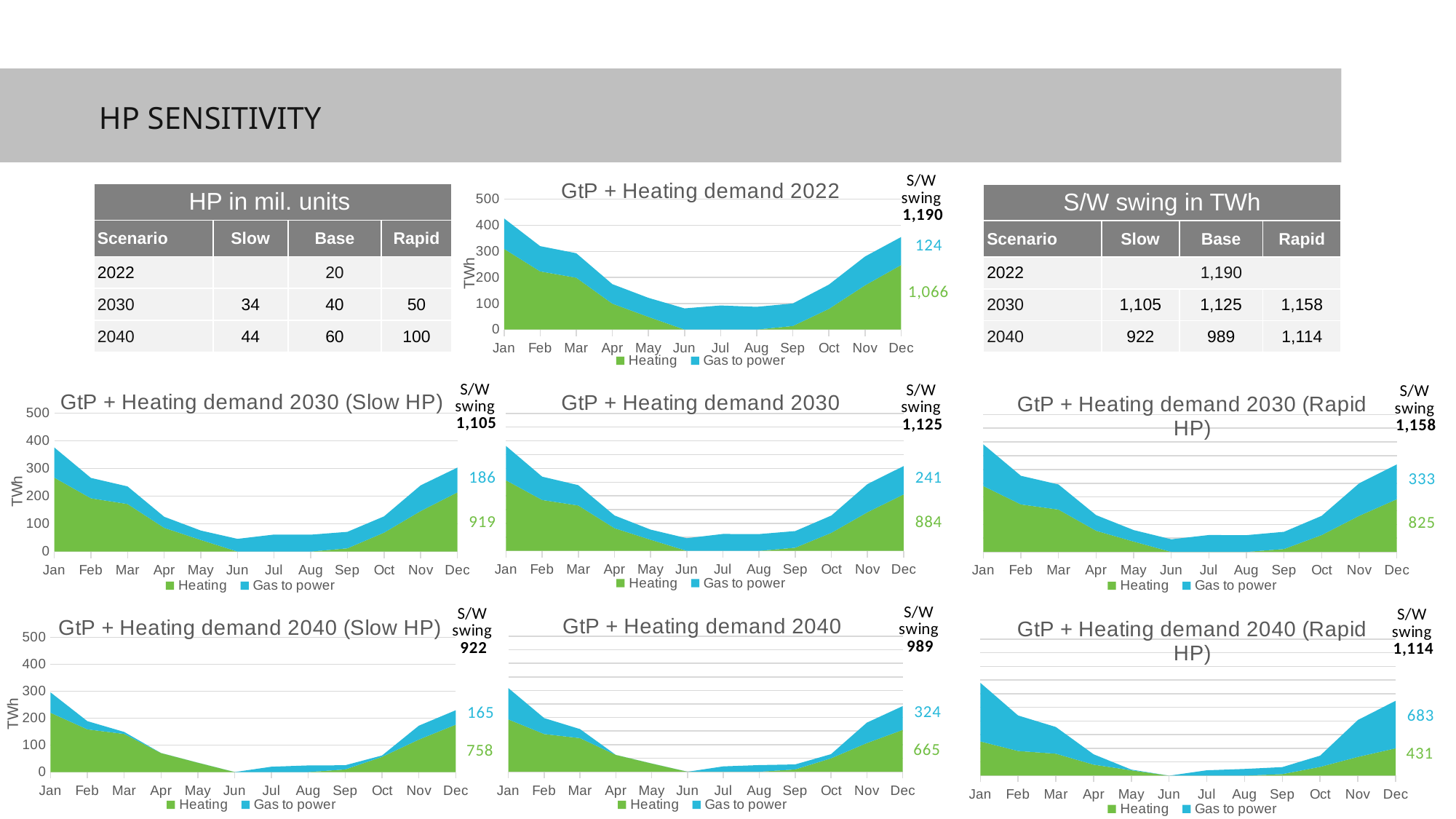
In "GtP + Heating demand 2040 (Rapid HP)", which has the larger S/W swing value, Heating or Gas to power? Gas to power What are the two legend entries in "GtP + Heating demand 2022"? Heating and Gas to power How many months are shown on the x axis of "GtP + Heating demand 2040 (Slow HP)"? 12 What is the Gas to power S/W swing value shown next to "GtP + Heating demand 2040 (Rapid HP)"? 683 What kind of chart is "GtP + Heating demand 2022"? area chart In "GtP + Heating demand 2030", does the total demand rise or fall from Jan to Jun? fall In "GtP + Heating demand 2040 (Rapid HP)", what is the difference between the Gas to power S/W swing (683) and the Heating S/W swing (431)? 252 What is the S/W swing value shown next to "GtP + Heating demand 2040"? 989 What is the Heating S/W swing value shown next to "GtP + Heating demand 2030 (Slow HP)"? 919 In "GtP + Heating demand 2040 (Slow HP)", is the total value for Jan greater or less than 400? less What is the S/W swing value shown next to "GtP + Heating demand 2022"? 1,190 How many series does the legend of "GtP + Heating demand 2030" list? 2